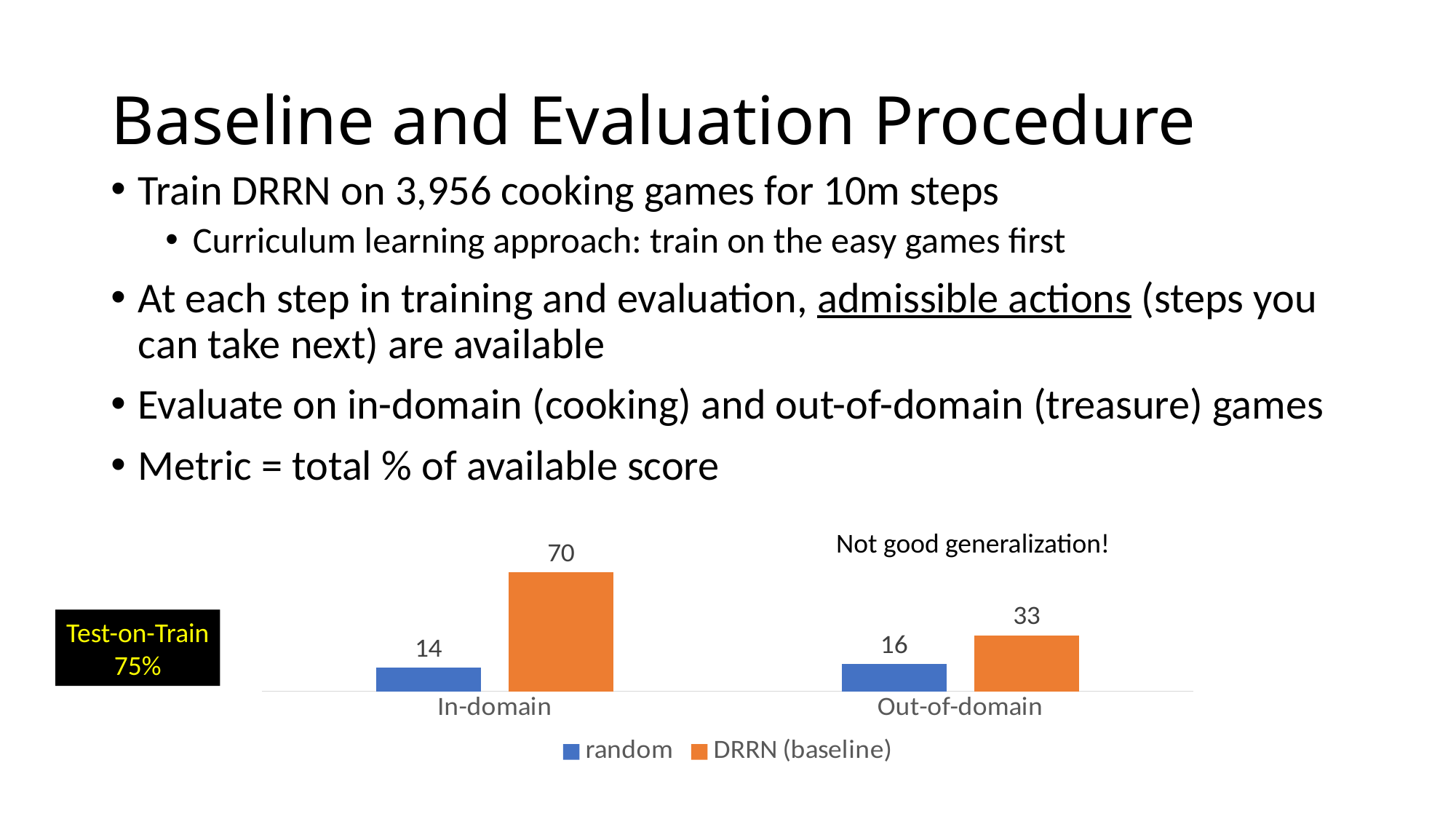
What is the value for random in the Out-of-domain category? 16 How many series does the chart legend list? 2 What is the value for random in the In-domain category? 14 What is the value for DRRN (baseline) in the Out-of-domain category? 33 What is the value for DRRN (baseline) in the In-domain category? 70 Which is larger in the Out-of-domain category, random or DRRN (baseline)? DRRN (baseline) Which category has the lowest random value? In-domain Which category has the highest DRRN (baseline) value? In-domain What is the difference between the DRRN (baseline) values for In-domain and Out-of-domain? 37 What is the difference between the DRRN (baseline) and random values in the In-domain category? 56 What kind of chart is shown on the slide? bar chart How many categories are shown on the x axis of the chart? 2